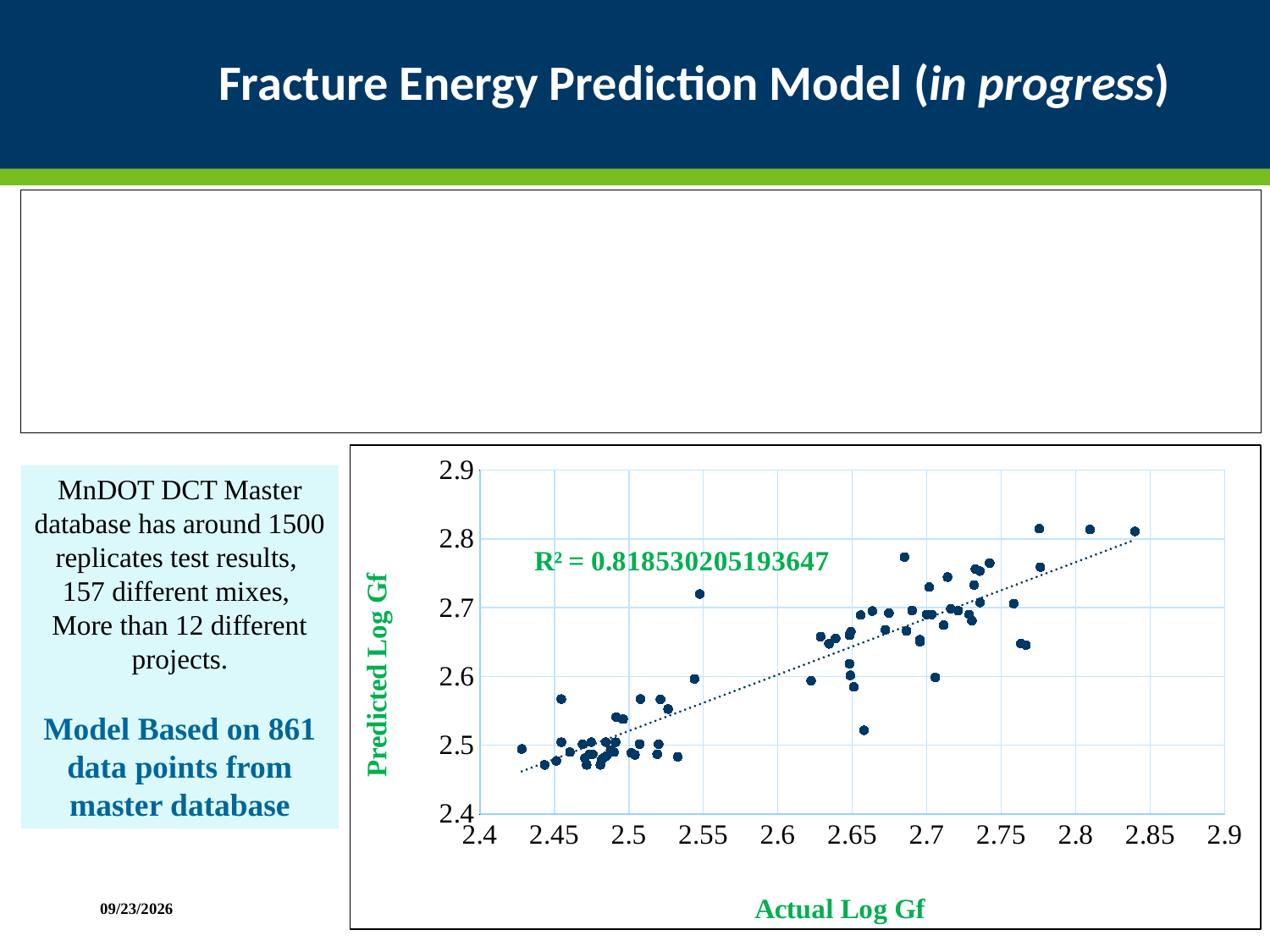
What is the label of the x axis of the chart? Actual Log Gf Do the plotted points generally rise or fall as Actual Log Gf increases? rise What is the R² value printed on the chart? 0.818530205193647 What is the highest value shown on the y axis of the chart? 2.9 Is the Predicted Log Gf of the point with the highest Actual Log Gf (near 2.84) greater or less than 2.7? greater What kind of chart is shown on the slide? scatter plot Is the Predicted Log Gf of the point with the lowest Actual Log Gf (near 2.43) greater or less than 2.6? less What is the lowest value shown on the x axis of the chart? 2.4